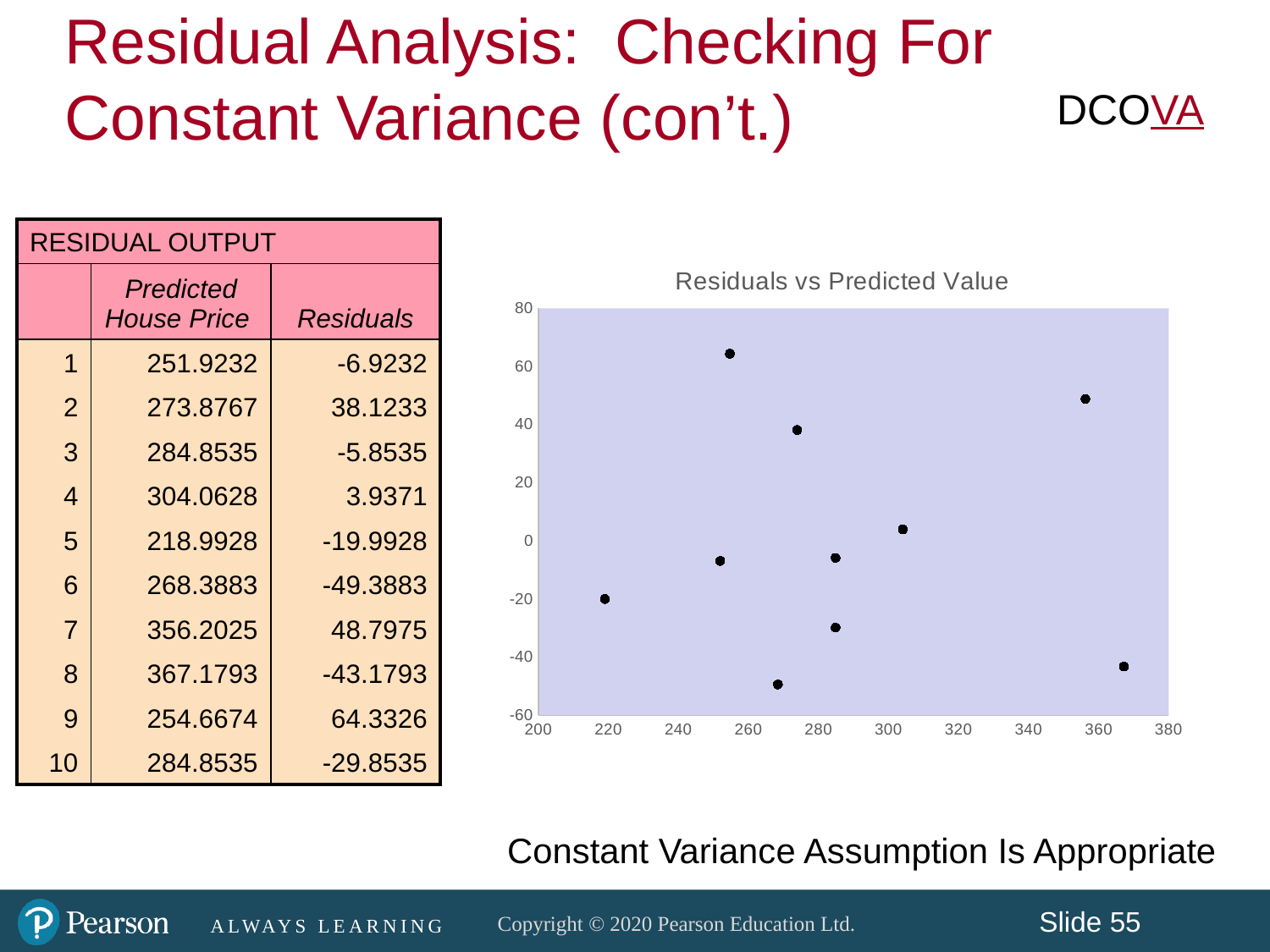
What is the title of the chart? Residuals vs Predicted Value What kind of chart is shown on the slide? scatter chart Is the residual of the point near a predicted value of 355 greater or less than 40? greater Is the residual of the point near a predicted value of 300 greater or less than 20? less How many points in the chart have a negative residual (below 0)? 6 Is the residual of the point with the smallest predicted value (near 220) greater or less than 0? less How many points in the chart have a positive residual (above 0)? 4 How many data points are plotted in the chart? 10 What is the range of the x axis in the chart? 200 to 380